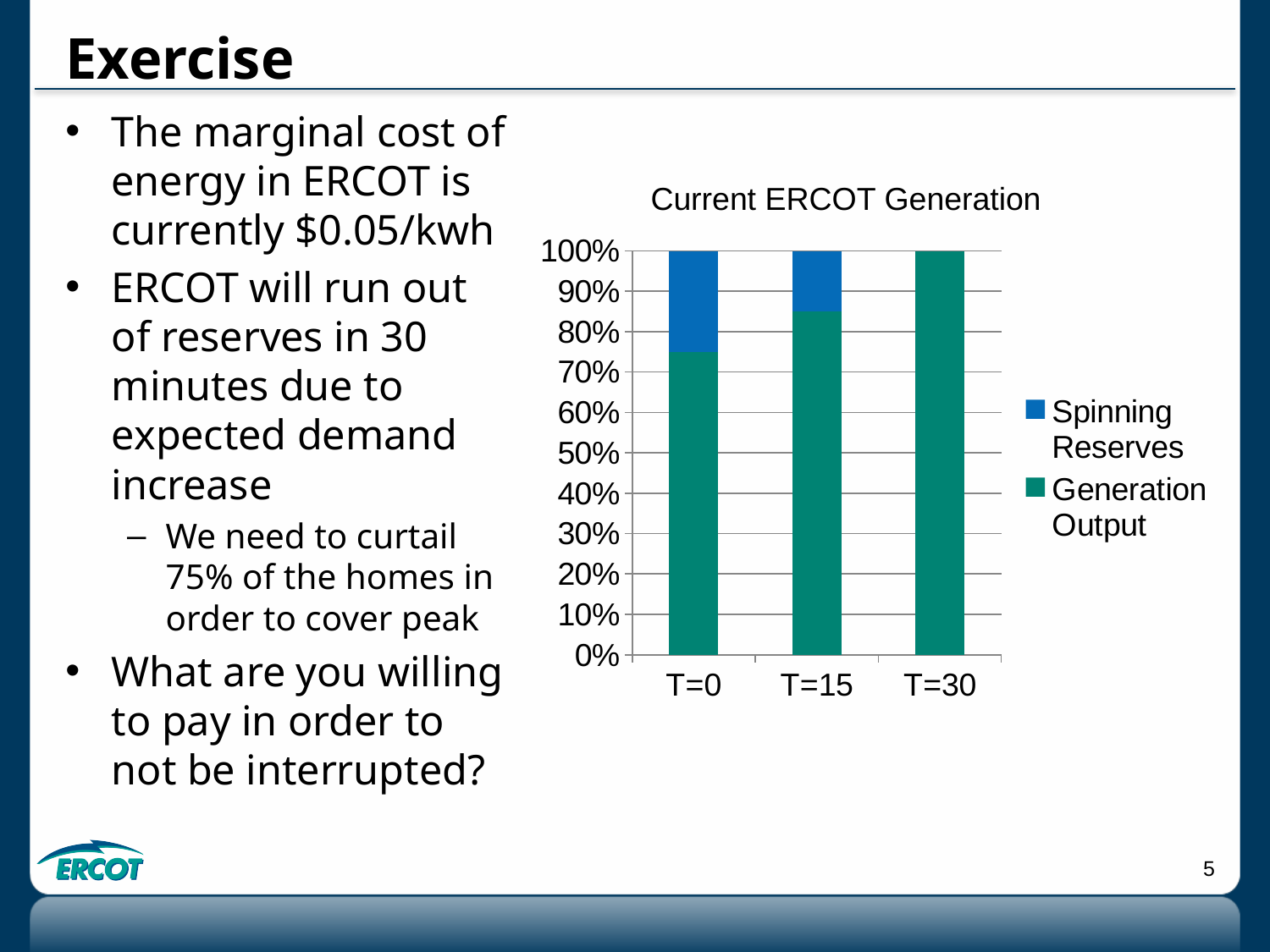
At which time point is Generation Output highest? T=30 At which time point is Spinning Reserves highest? T=0 Is the Spinning Reserves value at T=0 greater or less than 20%? greater How many categories are shown on the x axis of the chart? 3 Is the Generation Output value at T=15 greater or less than 90%? less What is the title of the chart? Current ERCOT Generation Which is larger, Generation Output at T=0 or at T=15? T=15 What kind of chart is shown on the slide? Stacked bar chart Does Generation Output rise or fall from T=0 to T=30? rise What is the Generation Output value at T=30? 100% How many series does the chart legend list? 2 Is the Generation Output value at T=0 greater or less than 70%? greater